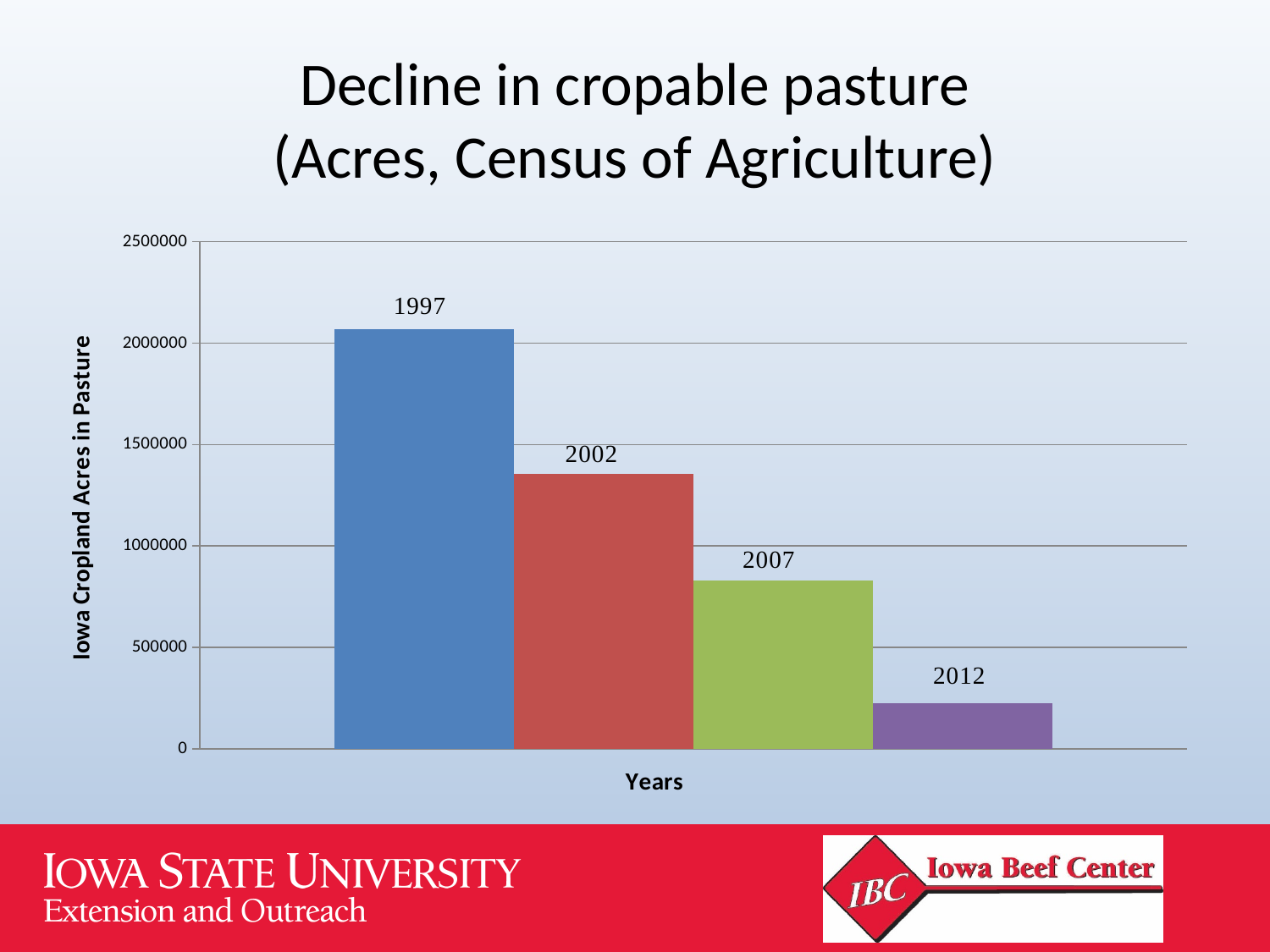
Is the value for 2002 greater or less than 1500000? less Is the value for 1997 greater or less than 2000000? greater Which year has the highest value for Iowa cropland acres in pasture? 1997 What is the label on the vertical axis of the chart? Iowa Cropland Acres in Pasture Is the value for 2007 greater or less than 1000000? less Which is larger, the value for 2002 or the value for 2007? 2002 Which year has the lowest value for Iowa cropland acres in pasture? 2012 What is the label on the horizontal axis of the chart? Years Do the values rise or fall from 1997 to 2012 along the x axis? fall How many bars are plotted in the chart? 4 What kind of chart is shown on the slide? bar chart